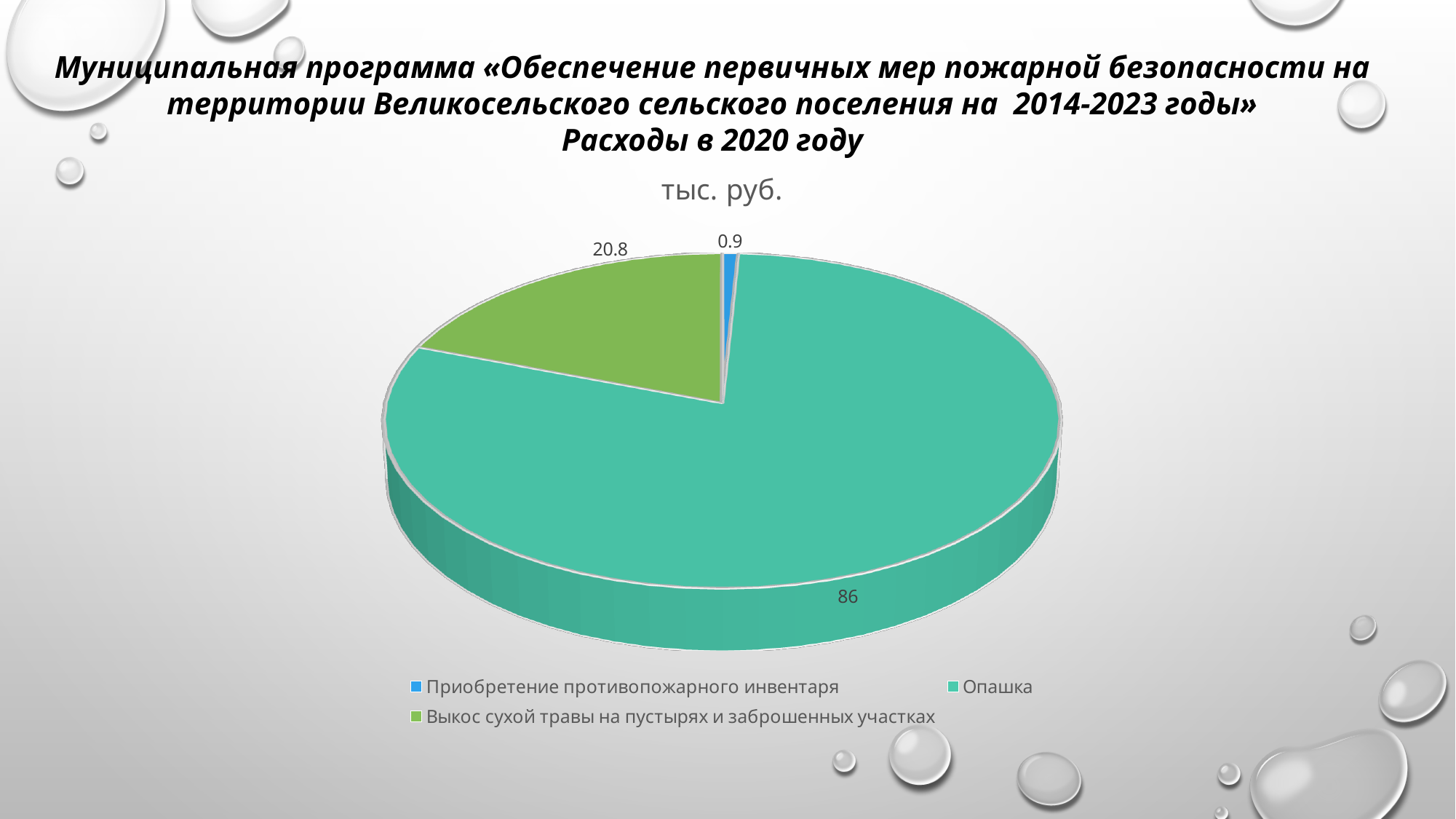
Which is larger: the value for Выкос сухой травы на пустырях и заброшенных участках or the value for Приобретение противопожарного инвентаря? Выкос сухой травы на пустырях и заброшенных участках What is the title of the chart? тыс. руб. What is the value for Приобретение противопожарного инвентаря? 0.9 What is the difference between the values for Выкос сухой травы на пустырях и заброшенных участках and Приобретение противопожарного инвентаря? 19.9 What kind of chart is shown on the slide? Pie chart How many categories does the pie chart have? 3 What is the value for Выкос сухой травы на пустырях и заброшенных участках? 20.8 What is the value for Опашка? 86 What is the total of all slices in the pie chart? 107.7 What is the difference between the values for Опашка and Выкос сухой травы на пустырях и заброшенных участках? 65.2 Which category has the largest slice of the pie? Опашка Which category has the smallest slice of the pie? Приобретение противопожарного инвентаря